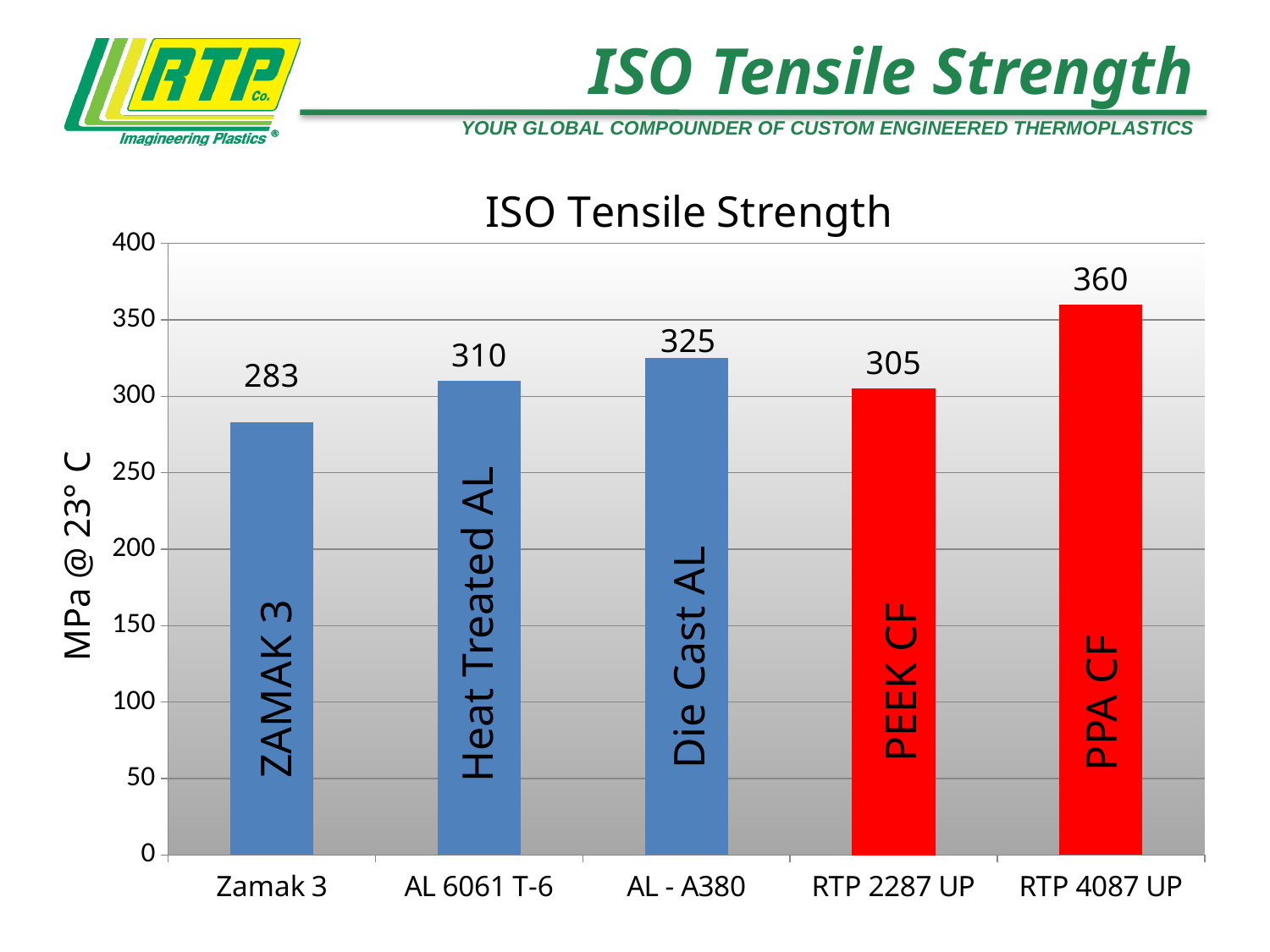
What is the ISO tensile strength value for AL 6061 T-6? 310 What is the ISO tensile strength value for Zamak 3? 283 Which category has the lowest ISO tensile strength? Zamak 3 What is the ISO tensile strength value for RTP 4087 UP? 360 Is the value for RTP 2287 UP greater or less than 250? greater What is the difference between the values for RTP 4087 UP and AL - A380? 35 Which is larger, the value for AL - A380 or the value for RTP 2287 UP? AL - A380 What is the label on the vertical axis of the chart? MPa @ 23° C What kind of chart is shown on the slide? Bar chart How many categories are shown on the x axis? 5 What is the difference between the values for AL 6061 T-6 and Zamak 3? 27 Which category has the highest ISO tensile strength? RTP 4087 UP